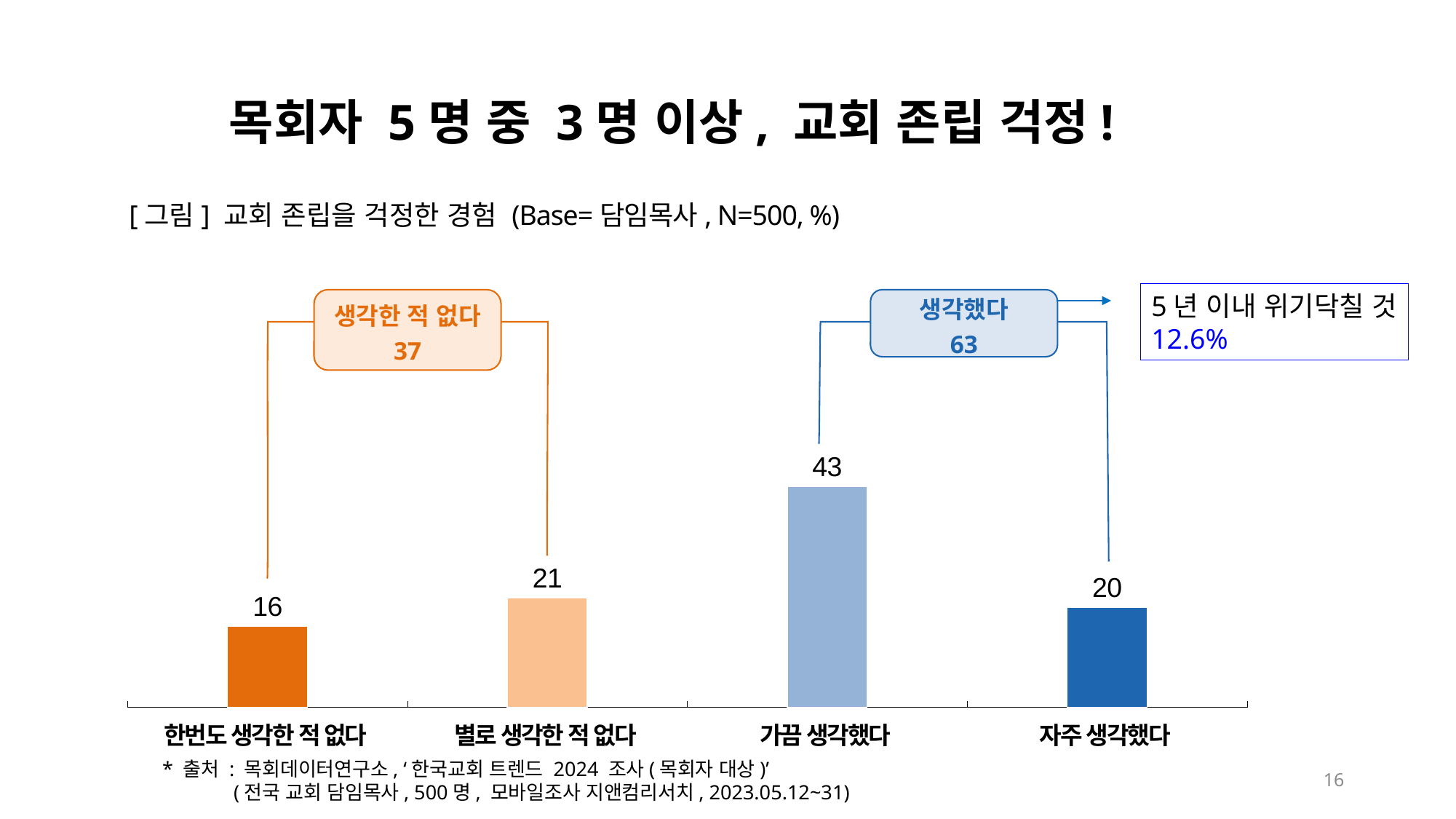
Which category has the highest value? 가끔 생각했다 What kind of chart is shown on the slide? bar chart What is the value for 자주 생각했다? 20 What is the value for 가끔 생각했다? 43 Which is larger, the value for 별로 생각한 적 없다 or the value for 자주 생각했다? 별로 생각한 적 없다 What percentage is given in the annotation box for 5년 이내 위기닥칠 것? 12.6% What combined value is shown in the box labelled 생각한 적 없다? 37 What is the value for 한번도 생각한 적 없다? 16 What is the difference between the values for 가끔 생각했다 and 별로 생각한 적 없다? 22 How many categories are shown on the x axis? 4 Which category has the lowest value? 한번도 생각한 적 없다 What combined value is shown in the box labelled 생각했다? 63